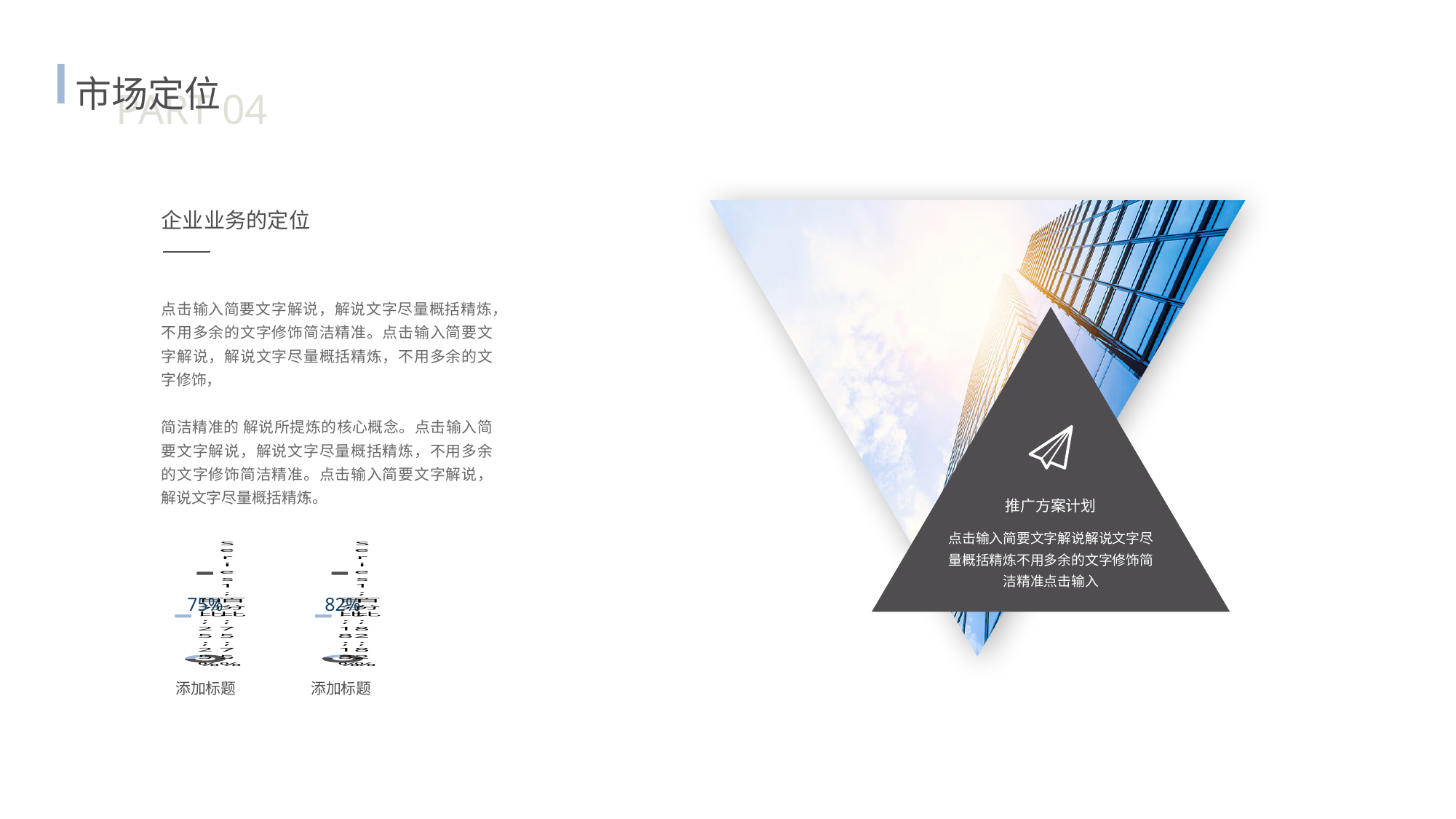
How many small charts are shown at the bottom left of the slide? 2 Is the value shown on the right small chart greater or less than 80%? greater What percentage is shown on the left small chart above the first "添加标题" caption? 75% Is the value shown on the left small chart greater or less than 80%? less What percentage is shown on the right small chart above the second "添加标题" caption? 82% What is the difference between the percentages shown on the right small chart (82%) and the left small chart (75%)? 7% Which of the two small charts at the bottom left shows the larger percentage, the left one or the right one? the right one What caption text appears below each of the two small charts? 添加标题